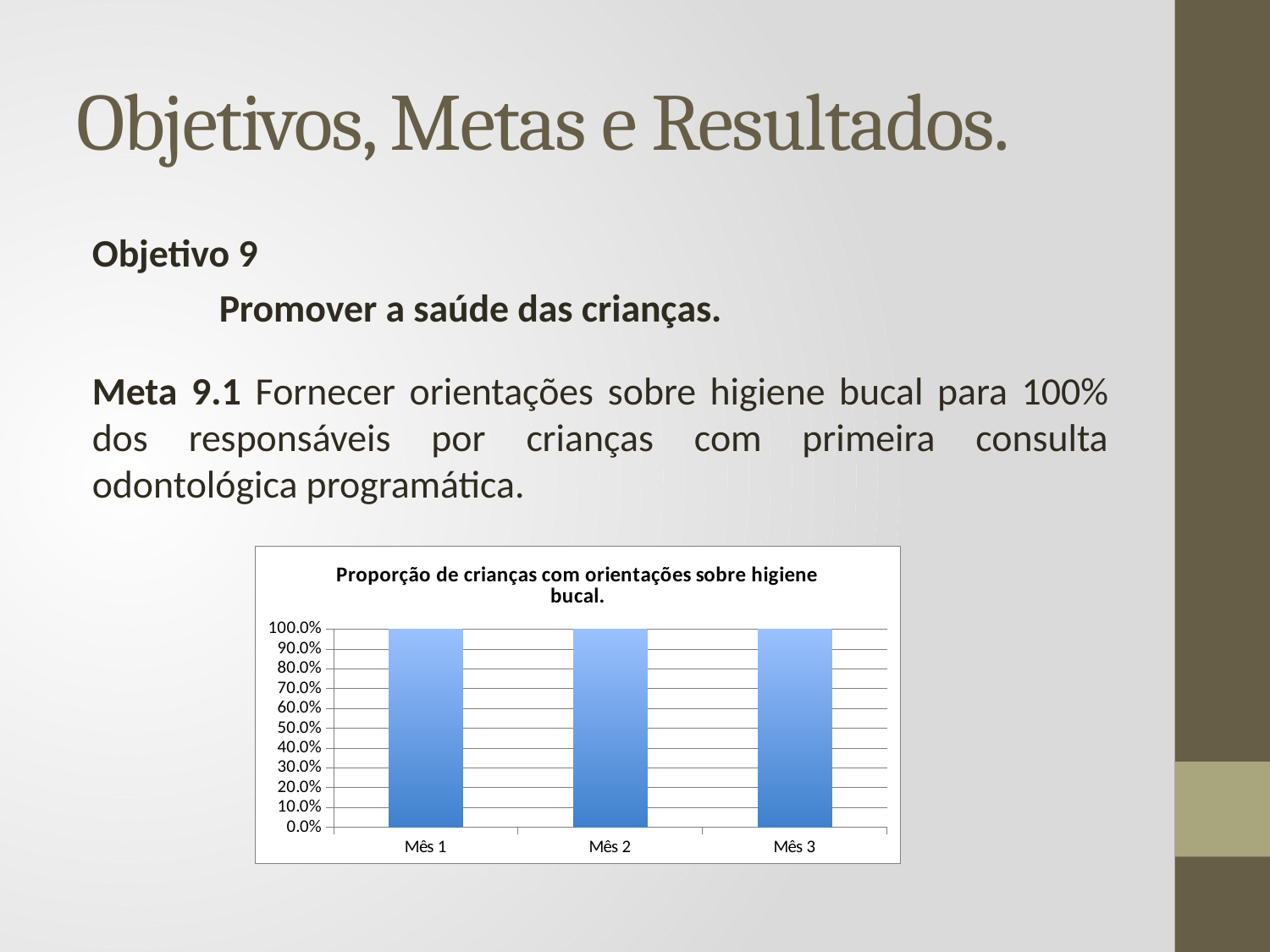
What kind of chart is shown on the slide? bar chart How many categories are shown on the x axis? 3 What is the difference between the values for Mês 1 and Mês 3? 0.0% What is the title of the chart? Proporção de crianças com orientações sobre higiene bucal. What colour are the bars in the chart? blue What is the value for Mês 3? 100.0% Is the value for Mês 3 greater or less than 90.0%? greater Do the values rise, fall, or stay the same from Mês 1 to Mês 3? stay the same What is the highest value shown on the y axis? 100.0% What is the value for Mês 1? 100.0% Is the value for Mês 2 greater or less than 50.0%? greater What is the value for Mês 2? 100.0%